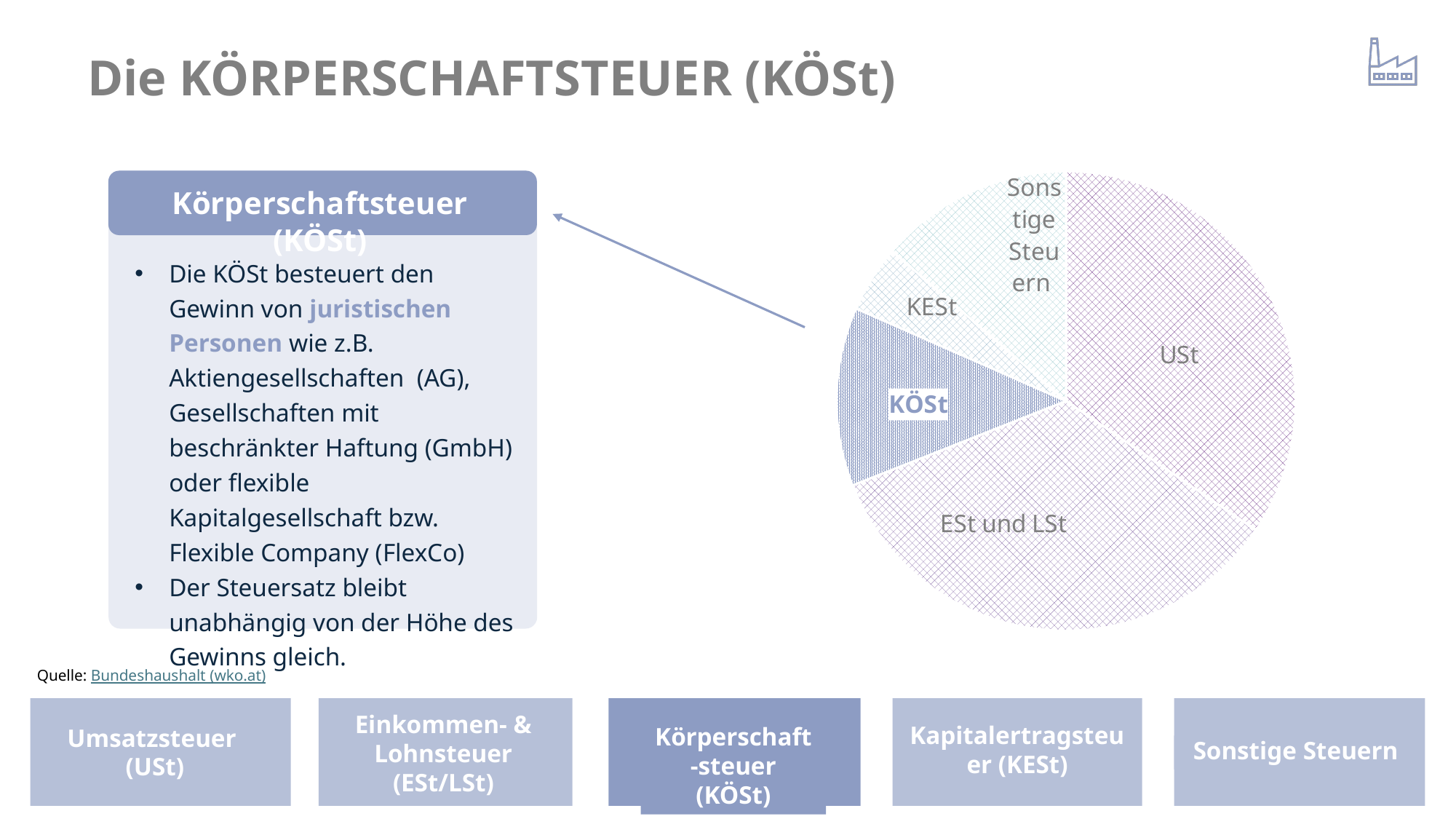
Which slice of the pie chart is larger, KÖSt or KESt? KÖSt How many slices does the pie chart have? 5 Which slice of the pie chart is larger, ESt und LSt or KÖSt? ESt und LSt Which slice of the pie chart does the arrow from the text box point to? KÖSt What kind of chart is shown on the slide? pie chart Which slice of the pie chart is larger, USt or KÖSt? USt Which slice of the pie chart is labelled in bold and highlighted in a darker colour? KÖSt